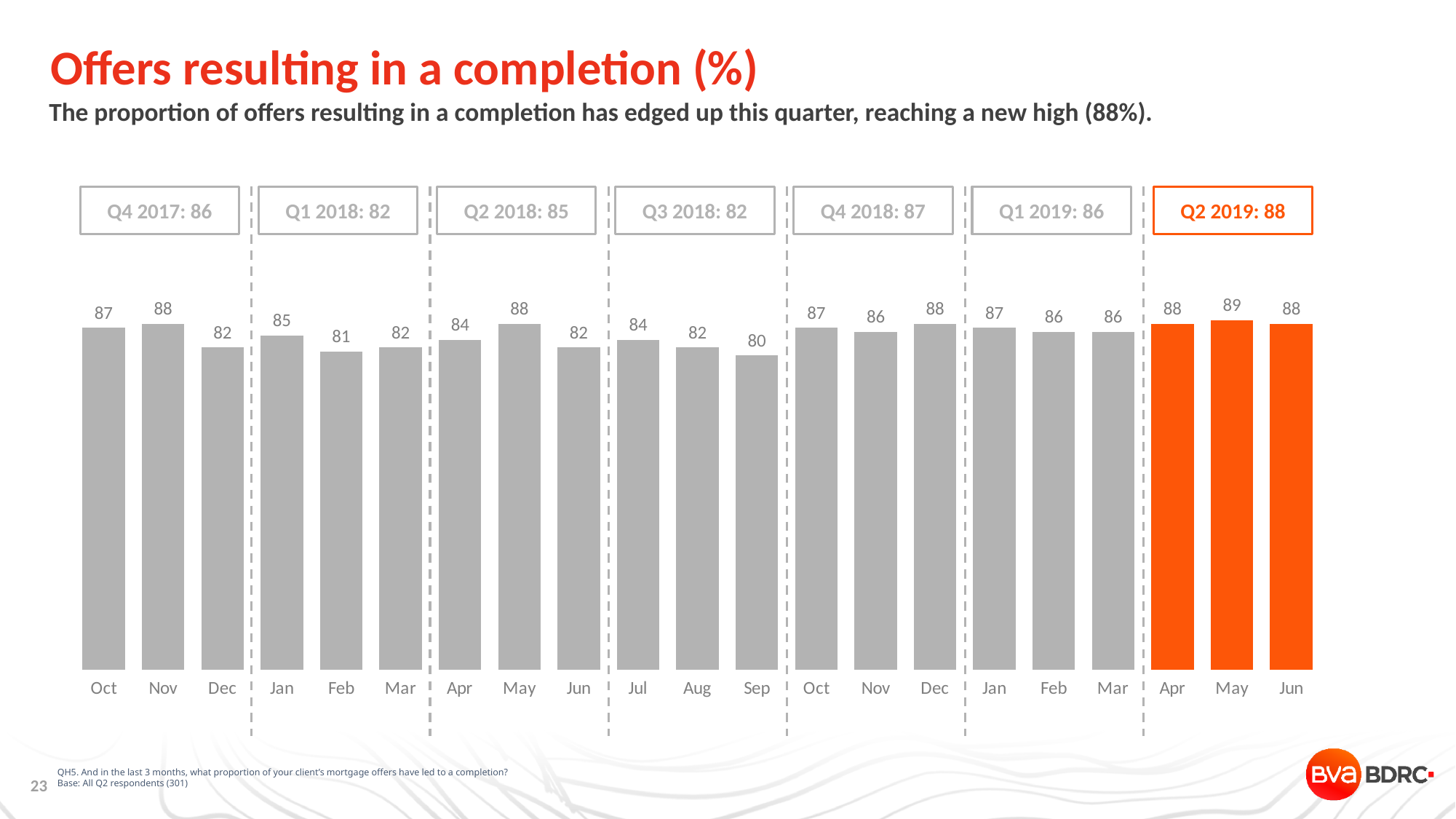
What is the value for May in the Q2 2019 section? 89 Which month has the highest value on the chart? May (Q2 2019) What is the difference between the value for May in Q2 2019 and the value for Sep in Q3 2018? 9 What kind of chart is shown on the slide? Bar chart Which is larger: the value for Dec in Q4 2017 or the value for Dec in Q4 2018? Dec in Q4 2018 What is the value for Feb in the Q1 2018 section? 81 How many monthly bars are plotted on the chart? 21 How many quarterly summary boxes are shown above the bars? 7 Which quarter's bars are coloured orange rather than grey? Q2 2019 What quarterly value is shown in the box for Q4 2018? 87 What is the value for Sep in the Q3 2018 section? 80 Which month has the lowest value on the chart? Sep (Q3 2018)